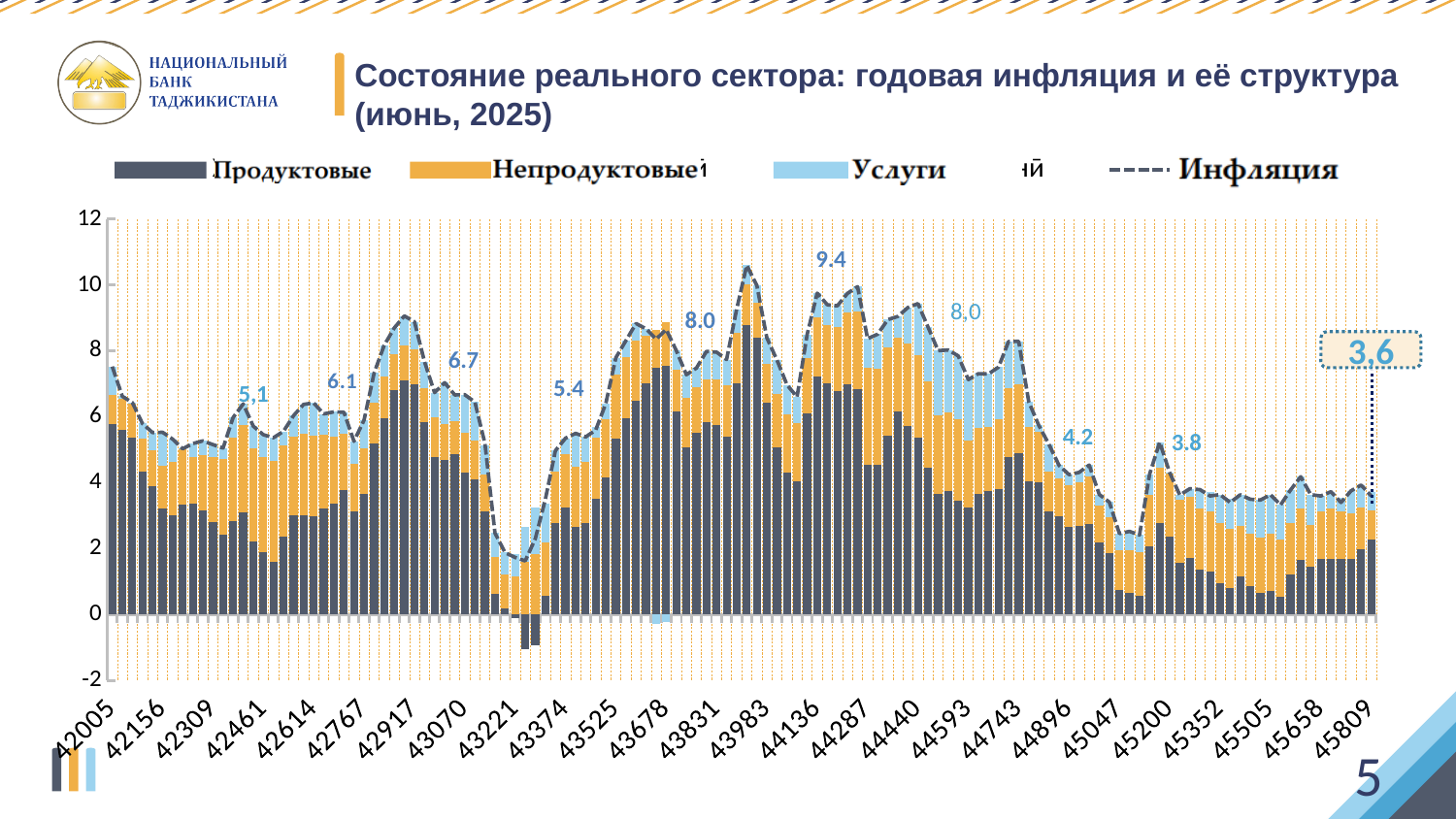
What is the difference between the peak labelled inflation value of 9.4 and the latest value of 3,6? 5.8 What kind of chart is shown on the slide? Stacked bar chart with a dashed line What is the highest inflation value labelled on the dashed line? 9.4 Which labelled inflation value is larger, 6.7 or 6.1? 6.7 Is the inflation line at the x-axis point 43221 greater or less than 2? less What is the most recent inflation value highlighted at the right end of the chart? 3,6 What is the lowest inflation value labelled on the dashed line? 3,6 Which series is shown in orange in the legend? Непродуктовые What is the maximum value shown on the vertical axis? 12 Does the inflation line rise or fall from the 9.4 peak to the right end of the chart? fall